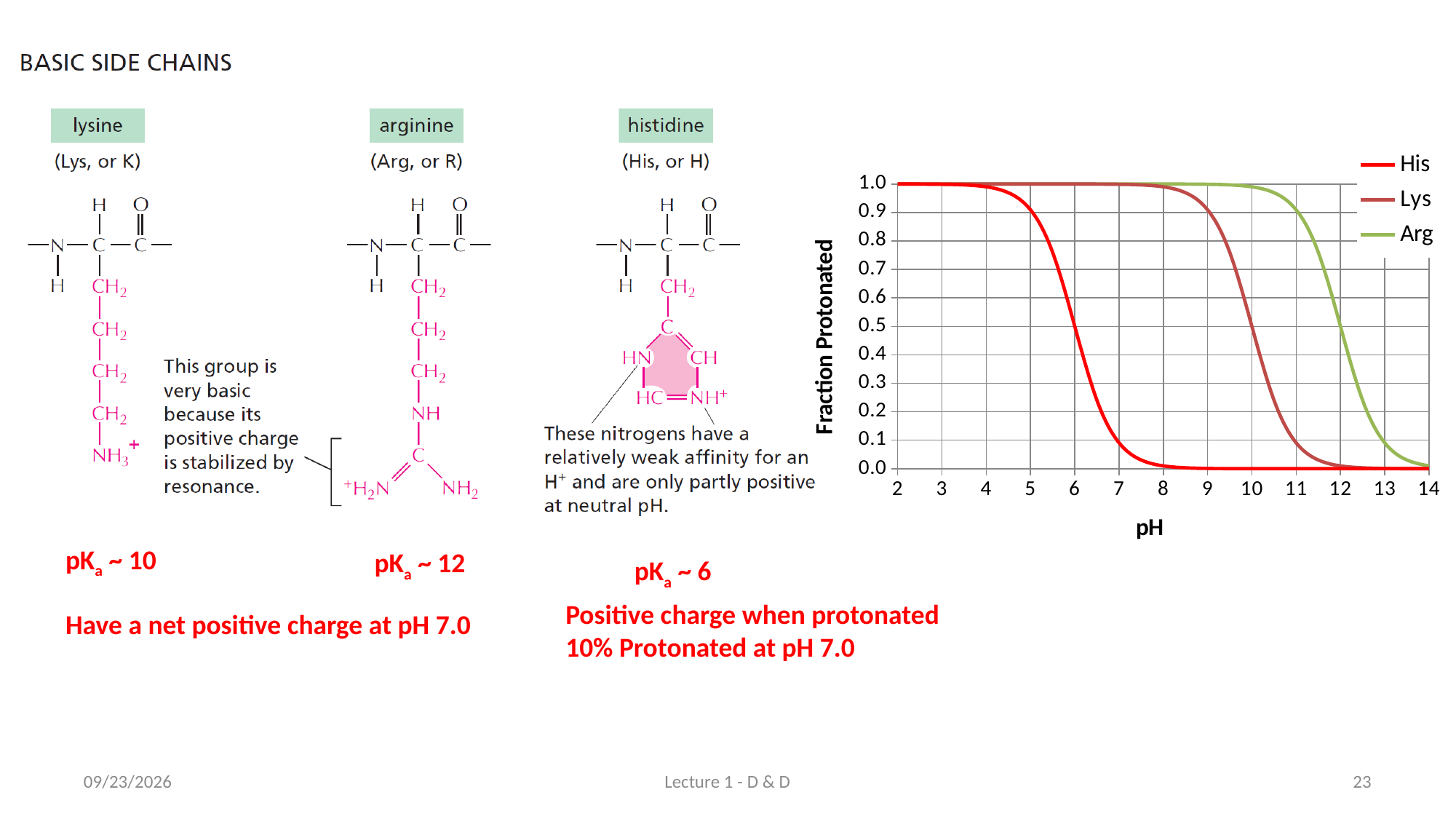
How many series does the legend of the Fraction Protonated chart list? 3 Is the fraction protonated for Arg at pH 10 greater or less than 0.9? greater At pH 6, which series has the higher fraction protonated, His or Lys? Lys What is the label of the y axis on the chart? Fraction Protonated At pH 10, which series has the higher fraction protonated, Arg or Lys? Arg Is the fraction protonated for Lys at pH 7 greater or less than 0.9? greater How many pH values are labelled on the x axis of the chart? 13 Is the fraction protonated for Lys at pH 12 greater or less than 0.1? less Which series are listed in the legend of the Fraction Protonated chart? His, Lys, Arg What kind of chart is shown on the right of the slide? line chart Do the curves on the Fraction Protonated chart rise or fall as pH increases? fall